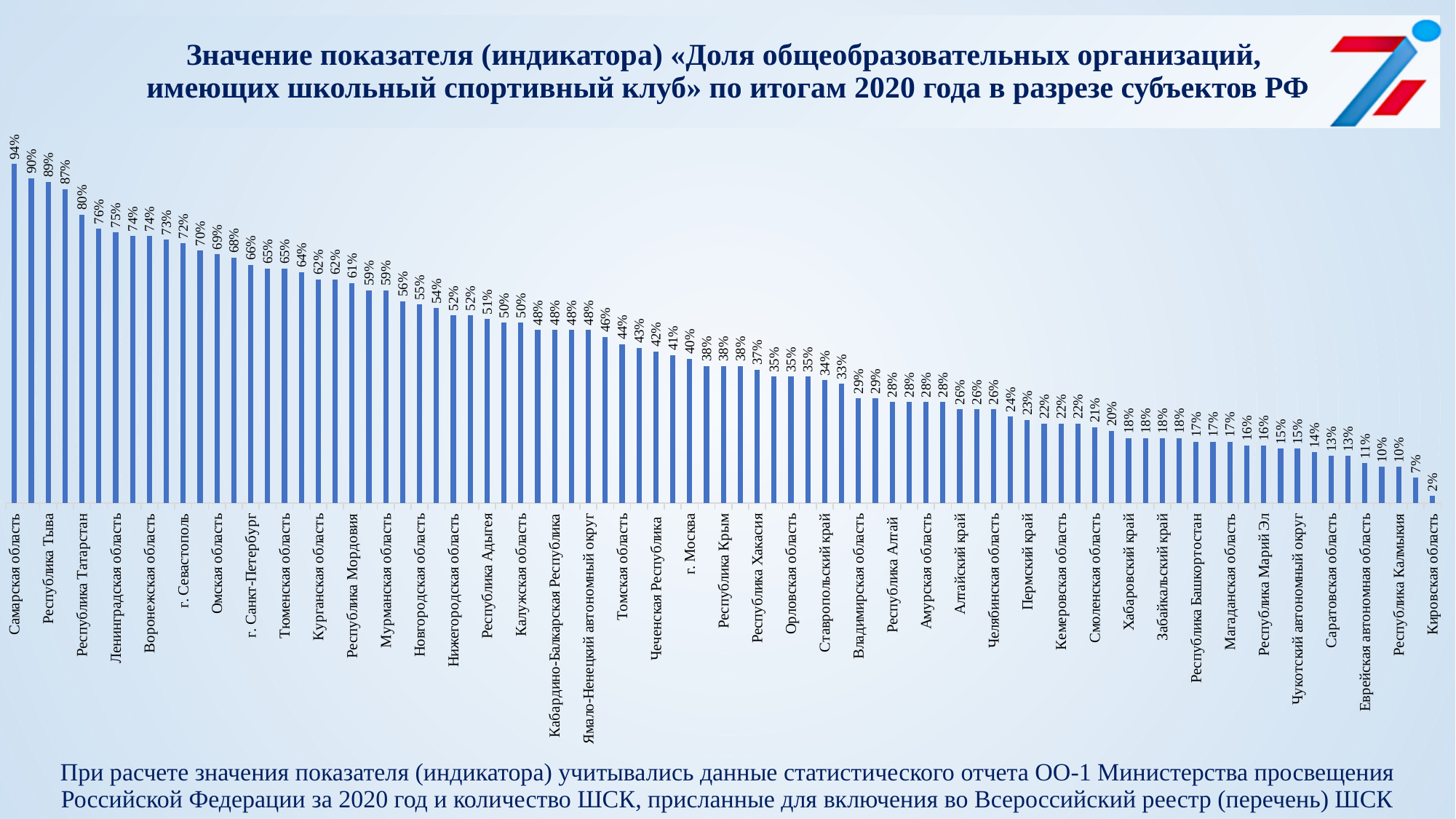
What year do the chart's results refer to, according to the title? 2020 What is the value for г. Москва? 40% Which has a larger value, Республика Тыва or Республика Калмыкия? Республика Тыва What is the difference between the values for Самарская область and Кировская область? 92 percentage points What kind of chart is shown on the slide? Bar chart Which has a larger value, г. Санкт-Петербург or г. Москва? г. Санкт-Петербург What is the value for Самарская область? 94% Which region has the lowest value on the chart? Кировская область What is the value for Кировская область? 2% Do the values rise or fall from left to right along the x axis? Fall Which region has the highest value on the chart? Самарская область What is the value for Республика Татарстан? 80%